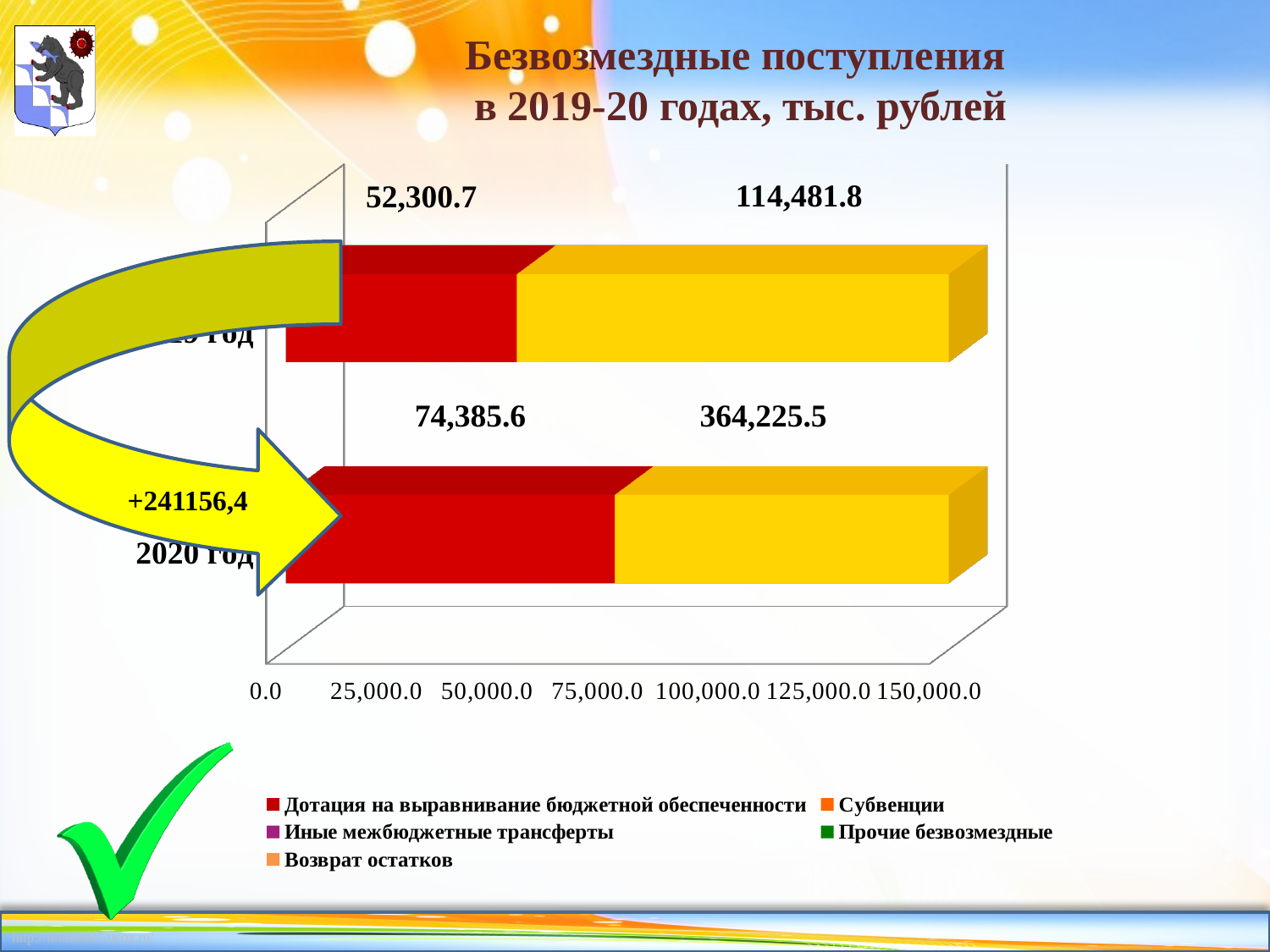
What is the value of Дотация на выравнивание бюджетной обеспеченности for 2020 год? 74,385.6 By how much did Дотация на выравнивание бюджетной обеспеченности increase from 2019 год to 2020 год? 22,084.9 How many series does the legend list? 5 What is the title of the chart? Безвозмездные поступления в 2019-20 годах, тыс. рублей What type of chart is shown on the slide? Stacked bar chart How many years (categories) are shown in the chart? 2 What is the value of Дотация на выравнивание бюджетной обеспеченности for 2019 год? 52,300.7 Which year has the larger value for Дотация на выравнивание бюджетной обеспеченности, 2019 год or 2020 год? 2020 год